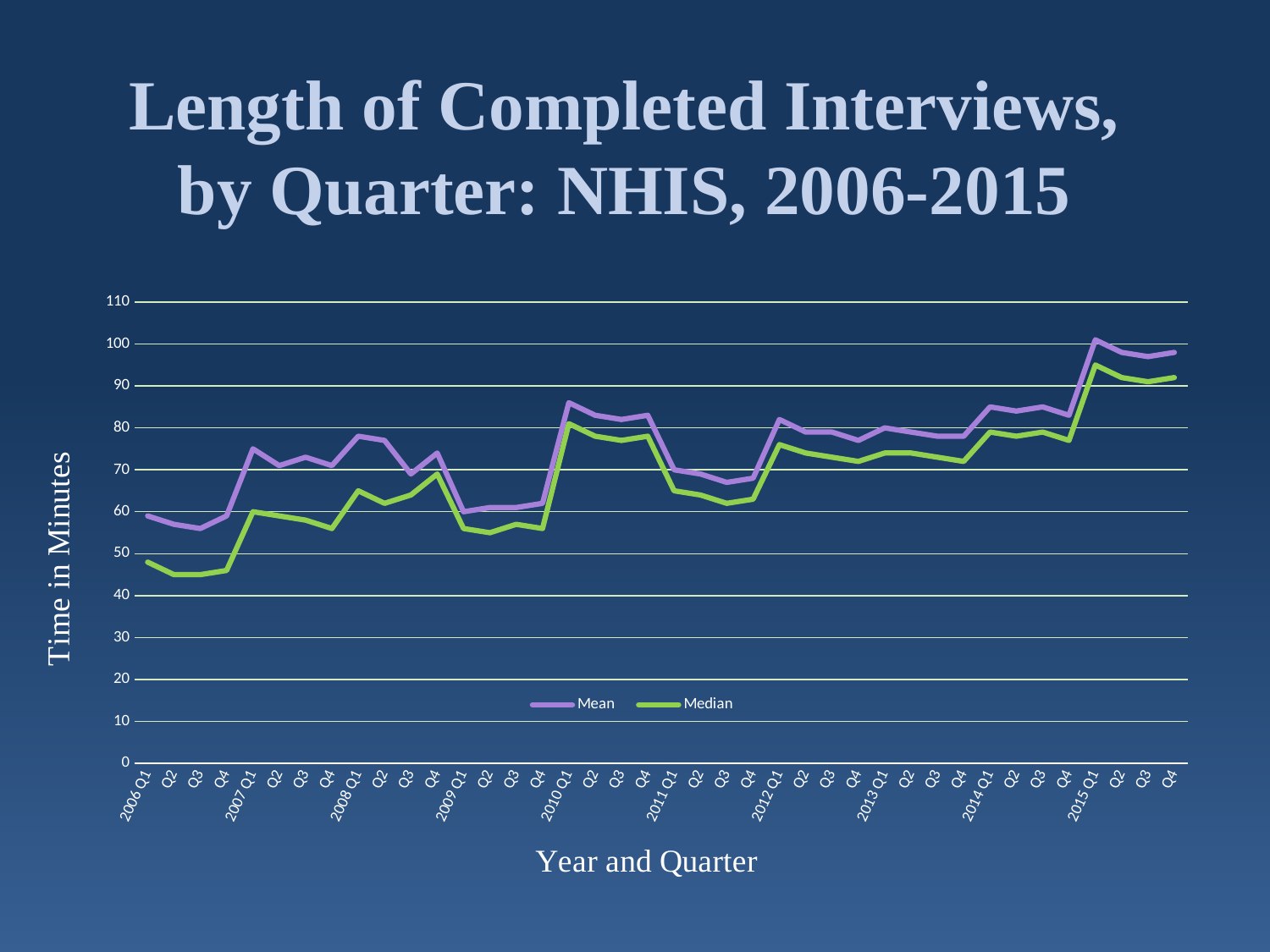
How many series does the legend list? 2 In which quarter is the Median interview length highest? 2015 Q1 What kind of chart is shown on the slide? Line chart How many quarterly data points are plotted for each series? 40 In 2007 Q1, which is larger, the Mean or the Median interview length? Mean Overall, do the interview lengths rise or fall from 2006 Q1 to 2015 Q4? Rise Is the Mean value for 2015 Q1 greater or less than 90? greater In which quarter is the Mean interview length highest? 2015 Q1 What is the label of the vertical axis? Time in Minutes Which two series are plotted in the chart? Mean and Median Is the Mean value for 2010 Q1 greater or less than 80? greater Is the Median value for 2006 Q1 greater or less than 50? less